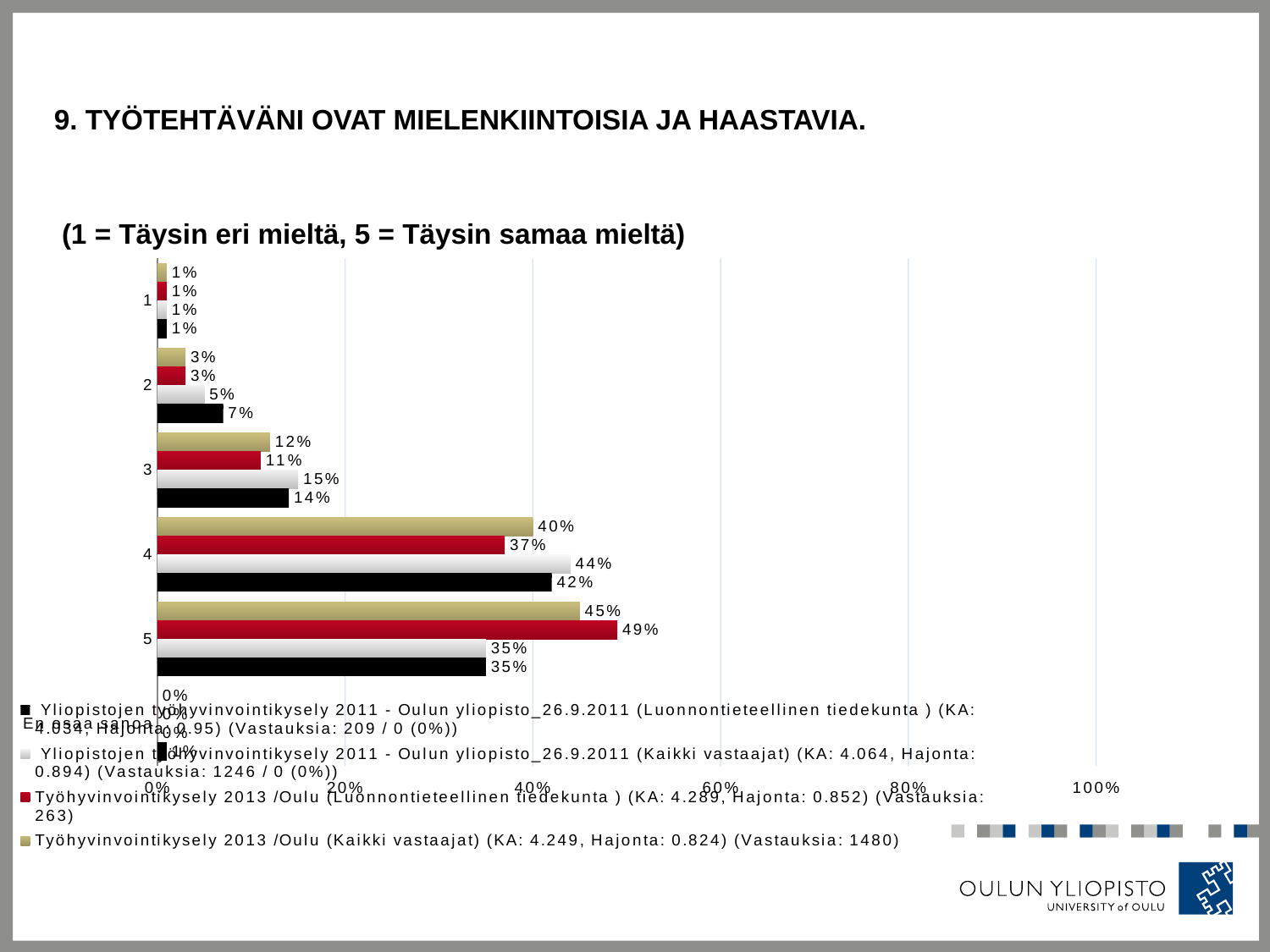
What is the value for category 5 in the Työhyvinvointikysely 2013 /Oulu (Luonnontieteellinen tiedekunta) series? 49% Which category has the highest value in the Yliopistojen työhyvinvointikysely 2011 (Kaikki vastaajat) series? 4 Which category has the highest value in the Työhyvinvointikysely 2013 /Oulu (Kaikki vastaajat) series? 5 What is the title of the chart on the slide? 9. TYÖTEHTÄVÄNI OVAT MIELENKIINTOISIA JA HAASTAVIA. Is the value for category 5 in the Työhyvinvointikysely 2013 /Oulu (Luonnontieteellinen tiedekunta) series greater or less than 40%? greater What is the value for category 4 in the Yliopistojen työhyvinvointikysely 2011 (Kaikki vastaajat) series? 44% What is the value for category 3 in the Työhyvinvointikysely 2013 /Oulu (Kaikki vastaajat) series? 12% What type of chart is shown on the slide? Bar chart For category 4, which series has the larger value: Työhyvinvointikysely 2013 /Oulu (Kaikki vastaajat) or Työhyvinvointikysely 2013 /Oulu (Luonnontieteellinen tiedekunta)? Työhyvinvointikysely 2013 /Oulu (Kaikki vastaajat) What is the difference between the Työhyvinvointikysely 2013 /Oulu (Luonnontieteellinen tiedekunta) value and the Yliopistojen työhyvinvointikysely 2011 (Luonnontieteellinen tiedekunta) value for category 5? 14% How many series does the legend list? 4 What is the value for category 2 in the Yliopistojen työhyvinvointikysely 2011 (Luonnontieteellinen tiedekunta) series? 7%